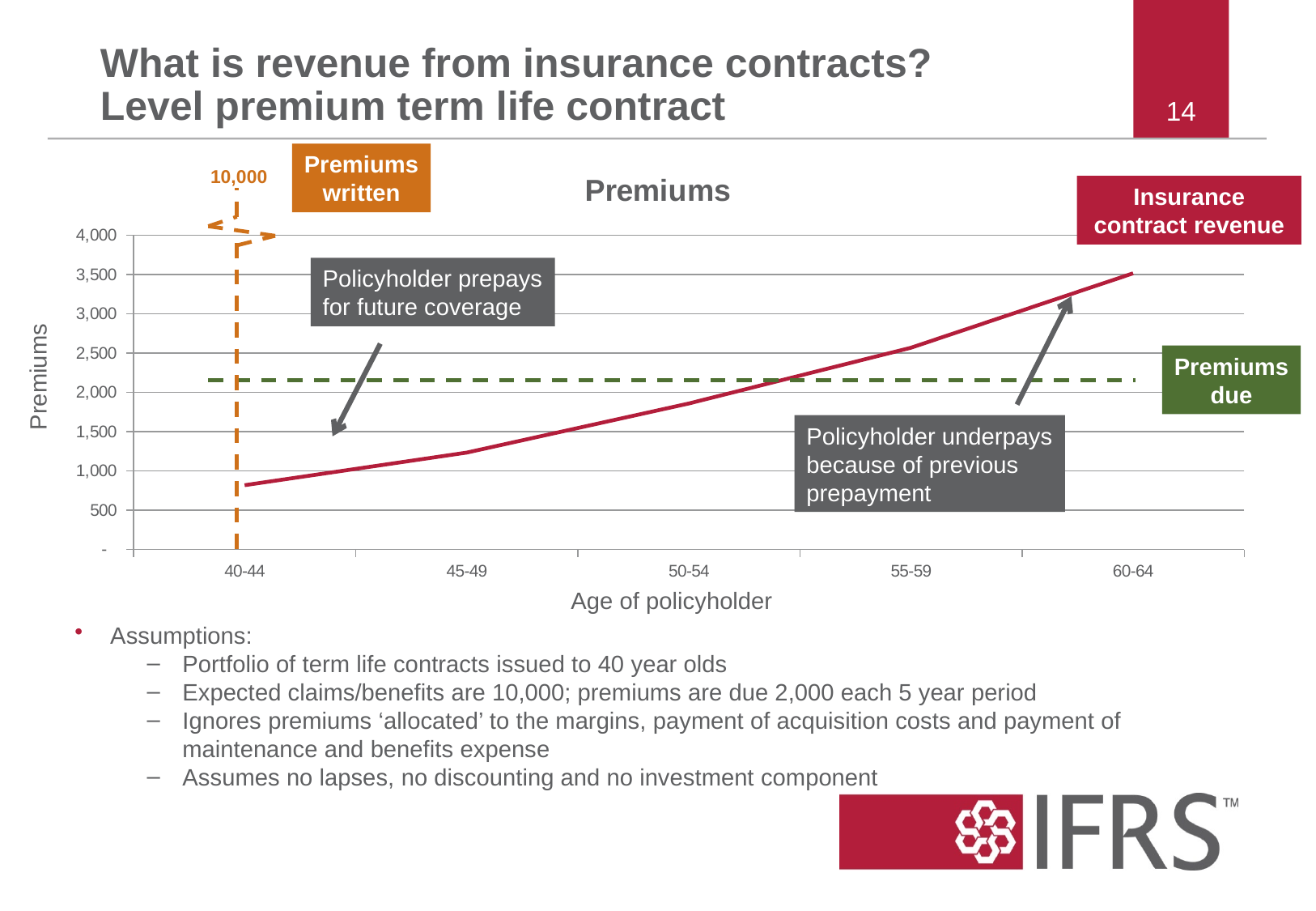
At age 40-44, which is larger: Insurance contract revenue or Premiums due? Premiums due What kind of chart is shown on the slide? line chart Does the Insurance contract revenue line rise or fall as the age of policyholder increases? rises Is the Insurance contract revenue for 55-59 greater or less than 2,000? greater Is the Insurance contract revenue for 60-64 greater or less than 3,000? greater In which age category is Insurance contract revenue lowest? 40-44 What is the title of the chart? Premiums How many age categories are shown on the x axis? 5 In which age category is Insurance contract revenue highest? 60-64 What is the x-axis title of the chart? Age of policyholder Is the Insurance contract revenue for 40-44 greater or less than 1,000? less